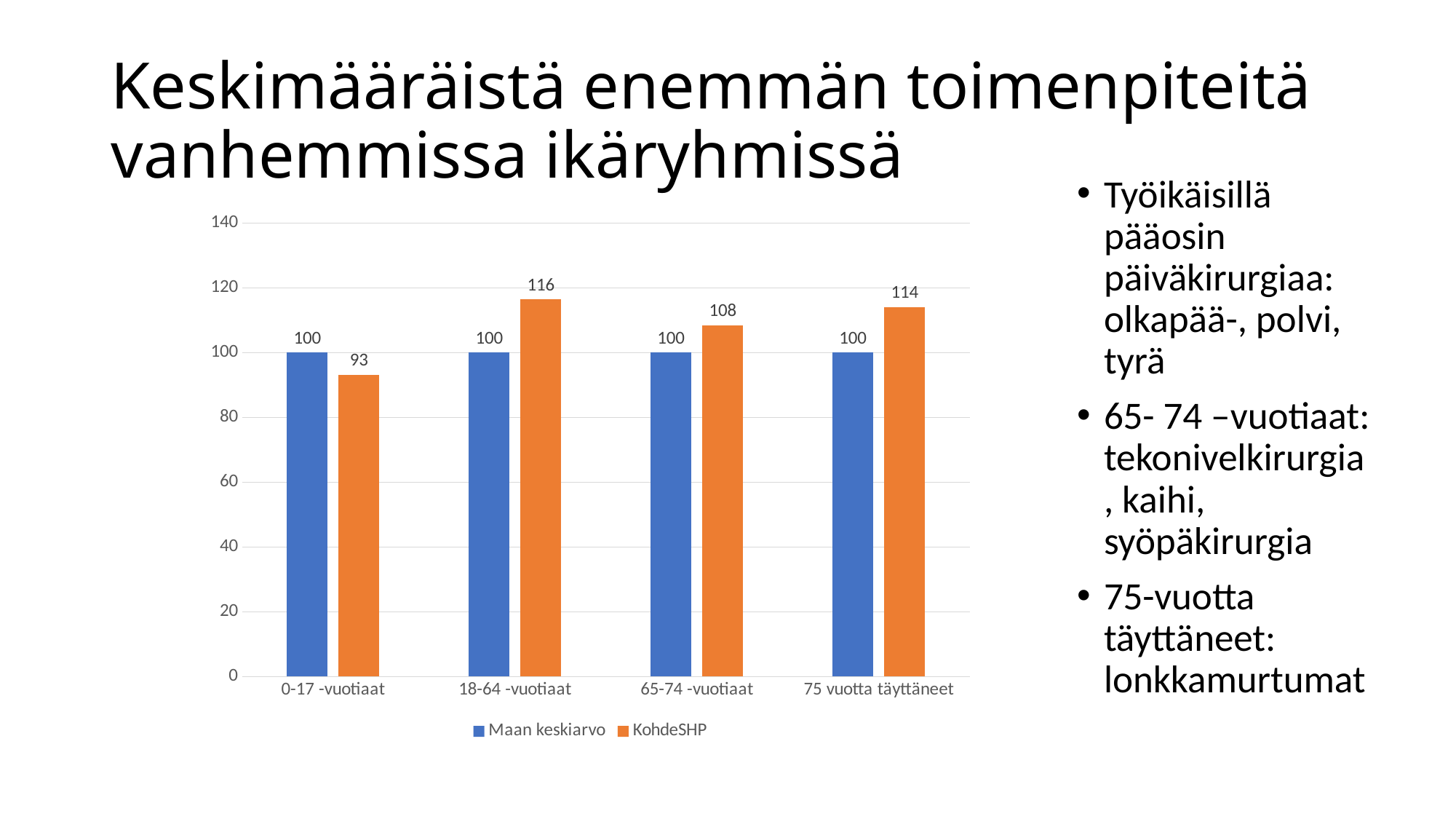
What is the Maan keskiarvo value for 75 vuotta täyttäneet? 100 Which age group has the highest KohdeSHP value? 18-64 -vuotiaat What is the KohdeSHP value for 18-64 -vuotiaat? 116 How many age groups are shown on the x axis? 4 What is the KohdeSHP value for 65-74 -vuotiaat? 108 For 0-17 -vuotiaat, which is larger: Maan keskiarvo or KohdeSHP? Maan keskiarvo How many series does the legend list? 2 What is the difference between the KohdeSHP value and the Maan keskiarvo value for 75 vuotta täyttäneet? 14 What is the KohdeSHP value for 0-17 -vuotiaat? 93 Which age group has the lowest KohdeSHP value? 0-17 -vuotiaat What kind of chart is shown on the slide? Bar chart Which colour represents the KohdeSHP series? Orange